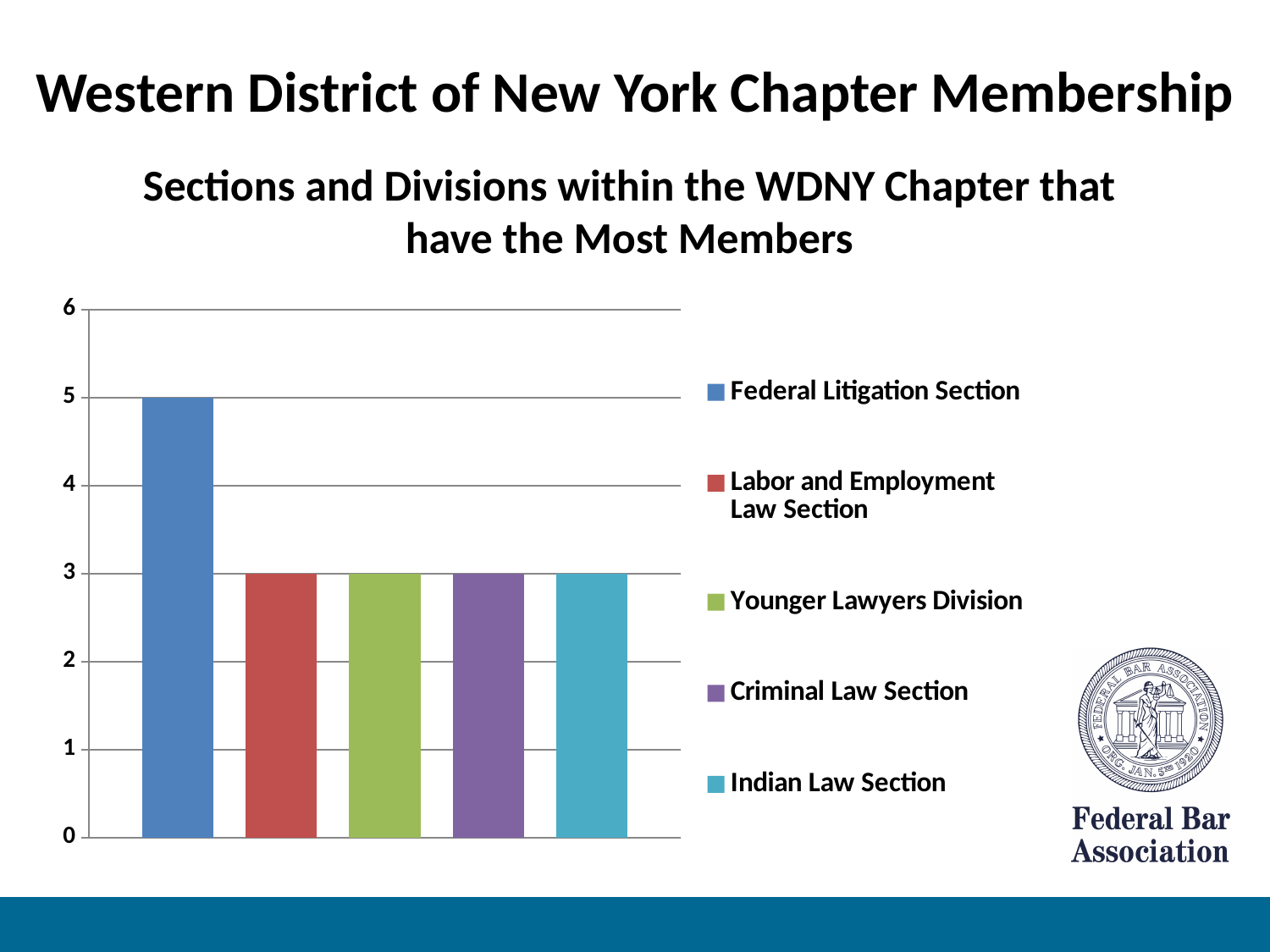
How many entries does the legend list? 5 Which section or division has the highest value? Federal Litigation Section Which is larger, the value for the Federal Litigation Section or the value for the Younger Lawyers Division? Federal Litigation Section Is the value for the Federal Litigation Section greater or less than 4? greater What is the title of the chart? Sections and Divisions within the WDNY Chapter that have the Most Members What is the difference between the Federal Litigation Section and the Criminal Law Section? 2 How many bars are plotted in the chart? 5 What is the value for the Labor and Employment Law Section? 3 What is the value for the Federal Litigation Section? 5 What is the value for the Younger Lawyers Division? 3 What type of chart is shown on the slide? bar chart What is the value for the Indian Law Section? 3